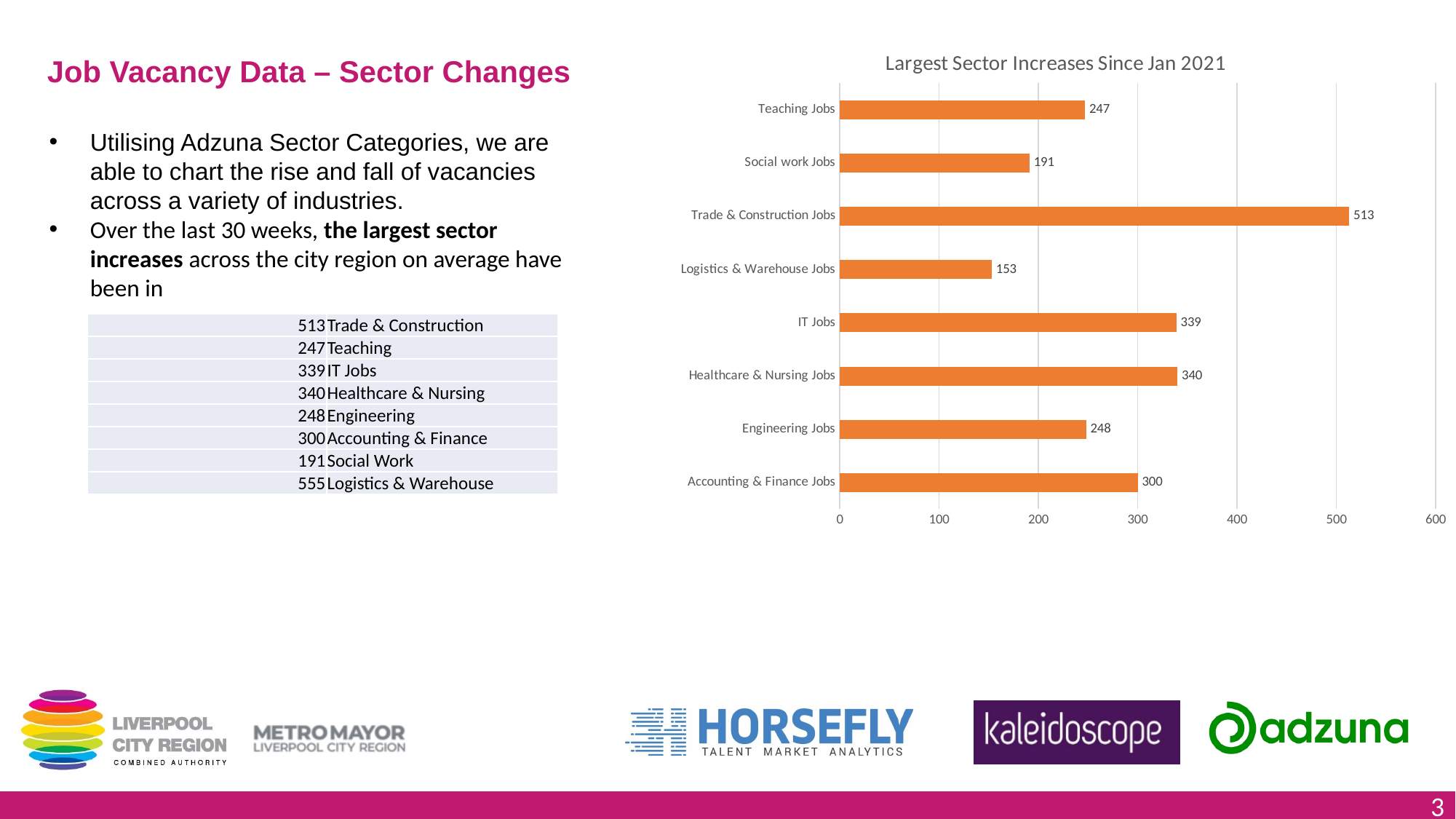
What is the difference between the values for Healthcare & Nursing Jobs and IT Jobs? 1 What is the value for Trade & Construction Jobs in the chart? 513 What is the title of the chart? Largest Sector Increases Since Jan 2021 Which sector has the highest value in the chart? Trade & Construction Jobs What is the value for Accounting & Finance Jobs in the chart? 300 What kind of chart is shown on the slide? Bar chart Is the value for Teaching Jobs greater or less than 200? greater What is the difference between the values for Trade & Construction Jobs and IT Jobs? 174 Which is larger, the value for Engineering Jobs or the value for Social work Jobs? Engineering Jobs What is the value for Logistics & Warehouse Jobs in the chart? 153 How many sectors are shown in the chart? 8 Which sector has the lowest value in the chart? Logistics & Warehouse Jobs